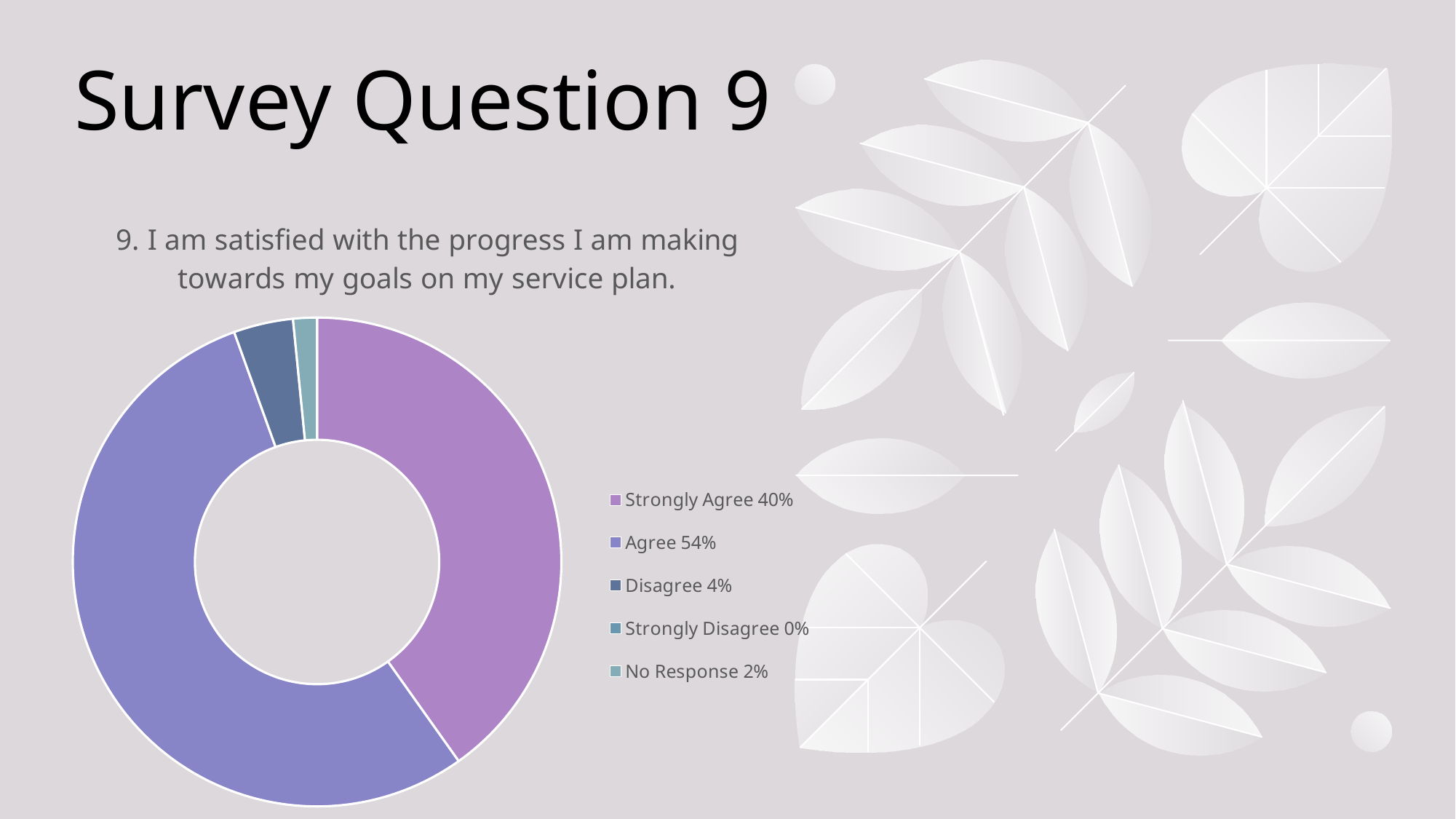
What is the difference between the Agree and Strongly Agree percentages? 14% How many response categories does the legend list? 5 What percentage is shown for No Response? 2% What percentage of respondents answered Disagree? 4% Which response category has the largest share? Agree Which response category has the smallest share? Strongly Disagree What percentage of respondents answered Agree? 54% What kind of chart is shown on the slide? Doughnut (pie) chart What percentage is shown for Strongly Disagree? 0% What percentage of respondents answered Strongly Agree? 40% Which is larger, the share for Disagree or the share for No Response? Disagree What is the combined percentage of Strongly Agree and Agree responses? 94%